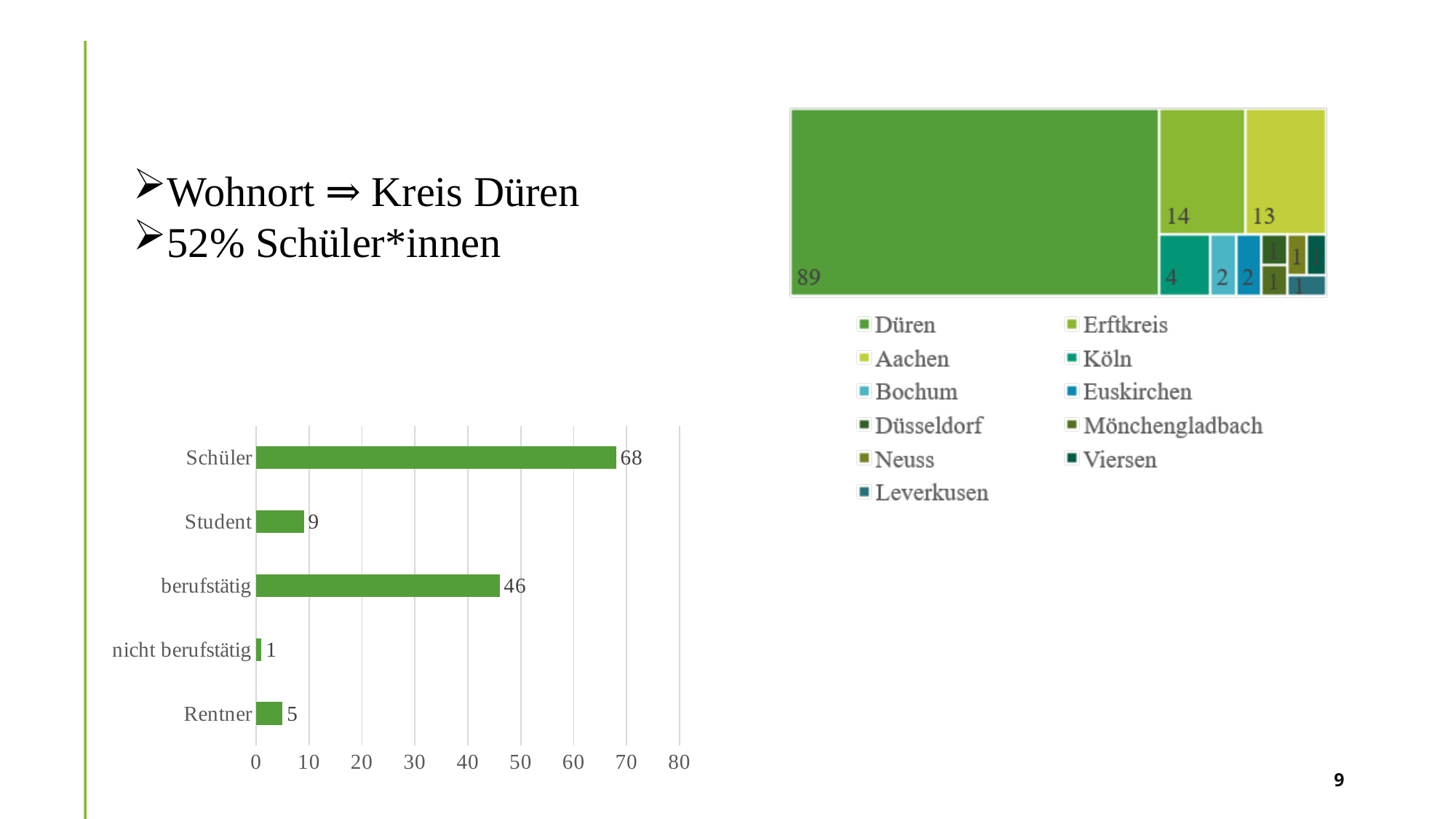
In the treemap on the right, what is the value for Düren? 89 How many entries does the legend of the treemap on the right list? 11 In the bar chart on the left, which is larger, the value for Student or the value for Rentner? Student In the bar chart on the left, which category has the lowest value? nicht berufstätig In the treemap on the right, what is the value for Erftkreis? 14 In the bar chart on the left, what is the difference between the values for Schüler and berufstätig? 22 In the bar chart on the left, what is the value for berufstätig? 46 How many categories does the bar chart on the left show? 5 In the bar chart on the left, what is the value for Rentner? 5 In the bar chart on the left, which category has the highest value? Schüler In the bar chart on the left, what is the value for Schüler? 68 What kind of chart is the chart on the left of the slide? bar chart